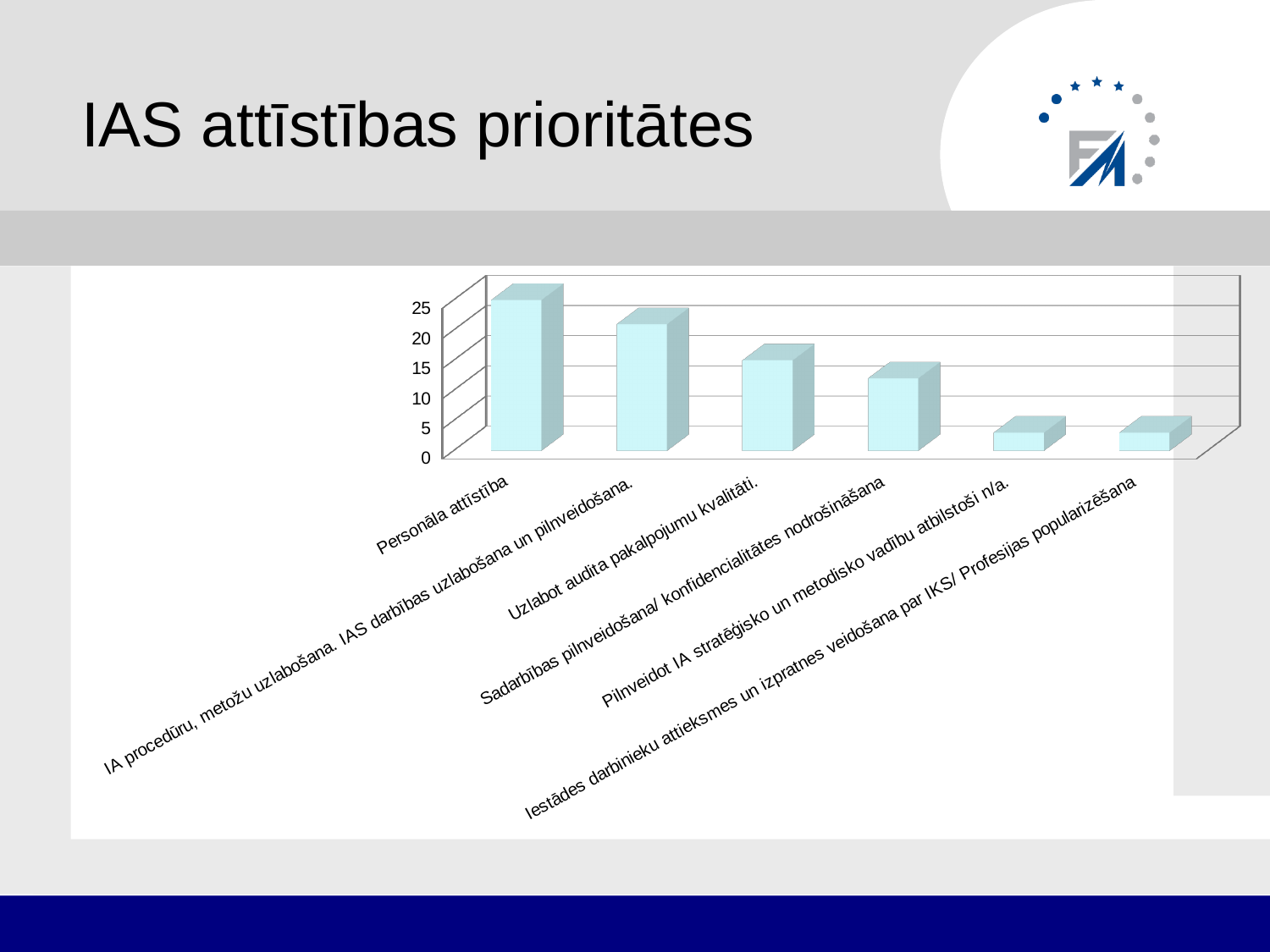
Do the values rise or fall moving from left to right across the categories? fall Is the value for 'Sadarbības pilnveidošana/ konfidencialitātes nodrošināšana' greater or less than 15? less How many categories are plotted in the chart? 6 Which category has the highest value in the chart? Personāla attīstība Is the value for Personāla attīstība greater or less than 20? greater Is the value for 'IA procedūru, metožu uzlabošana. IAS darbības uzlabošana un pilnveidošana.' greater or less than 15? greater What kind of chart is shown on the slide? bar chart Which has the larger value: Personāla attīstība or 'Uzlabot audita pakalpojumu kvalitāti.'? Personāla attīstība What is the title of the slide containing the chart? IAS attīstības prioritātes